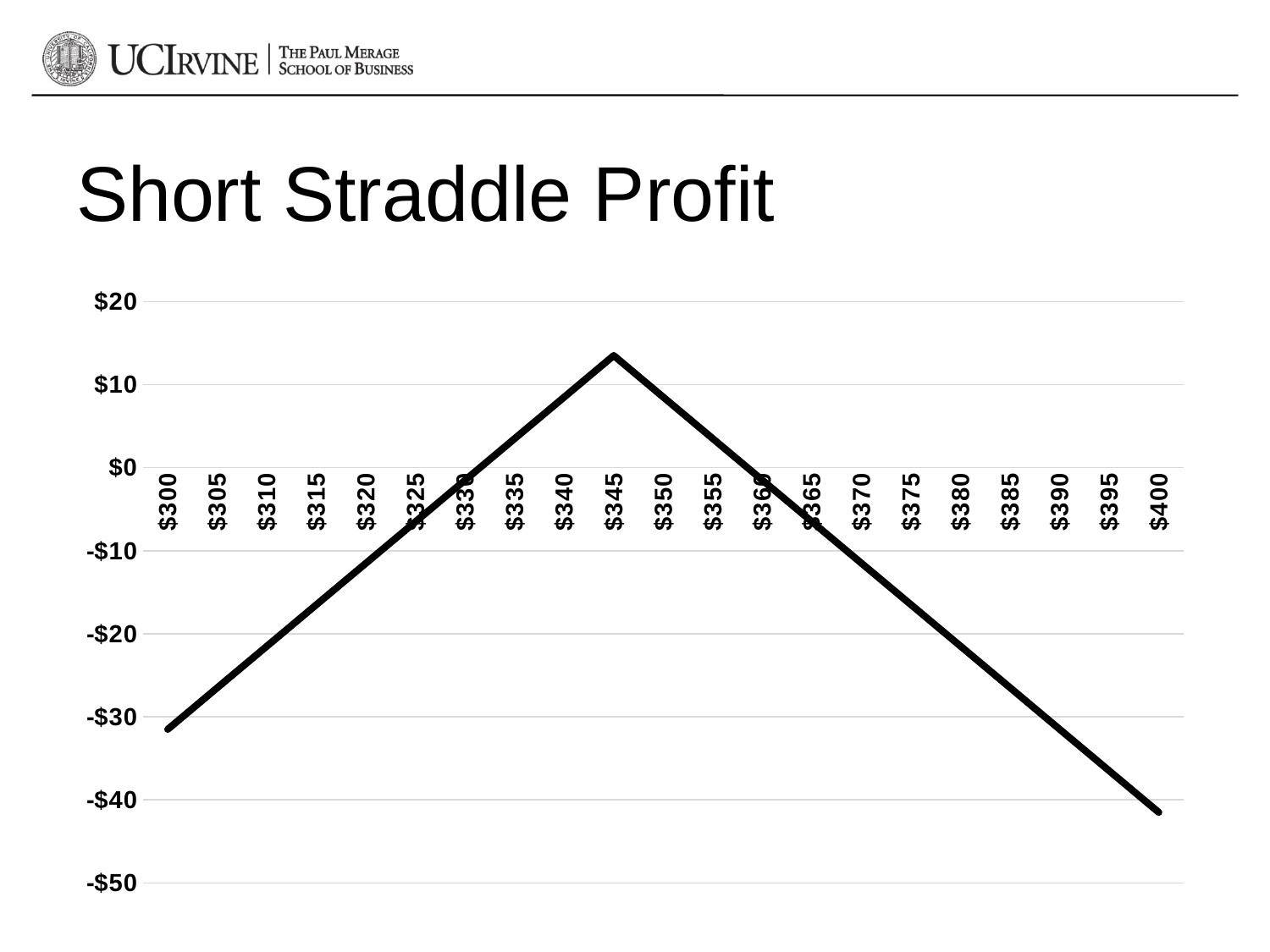
At which stock price on the x axis does the profit line reach its lowest point? $400 Is the profit at $345 greater or less than $10? greater Is the profit at $350 greater or less than $0? greater What is the title of the chart? Short Straddle Profit How many stock price points are labelled along the x axis? 21 Which has the larger profit, a stock price of $300 or $400? $300 Is the profit at $400 greater or less than -$30? less Do the profit values rise or fall as the stock price moves from $345 to $400? fall What kind of chart is shown on the slide? line chart At which stock price on the x axis does the profit line reach its highest point? $345